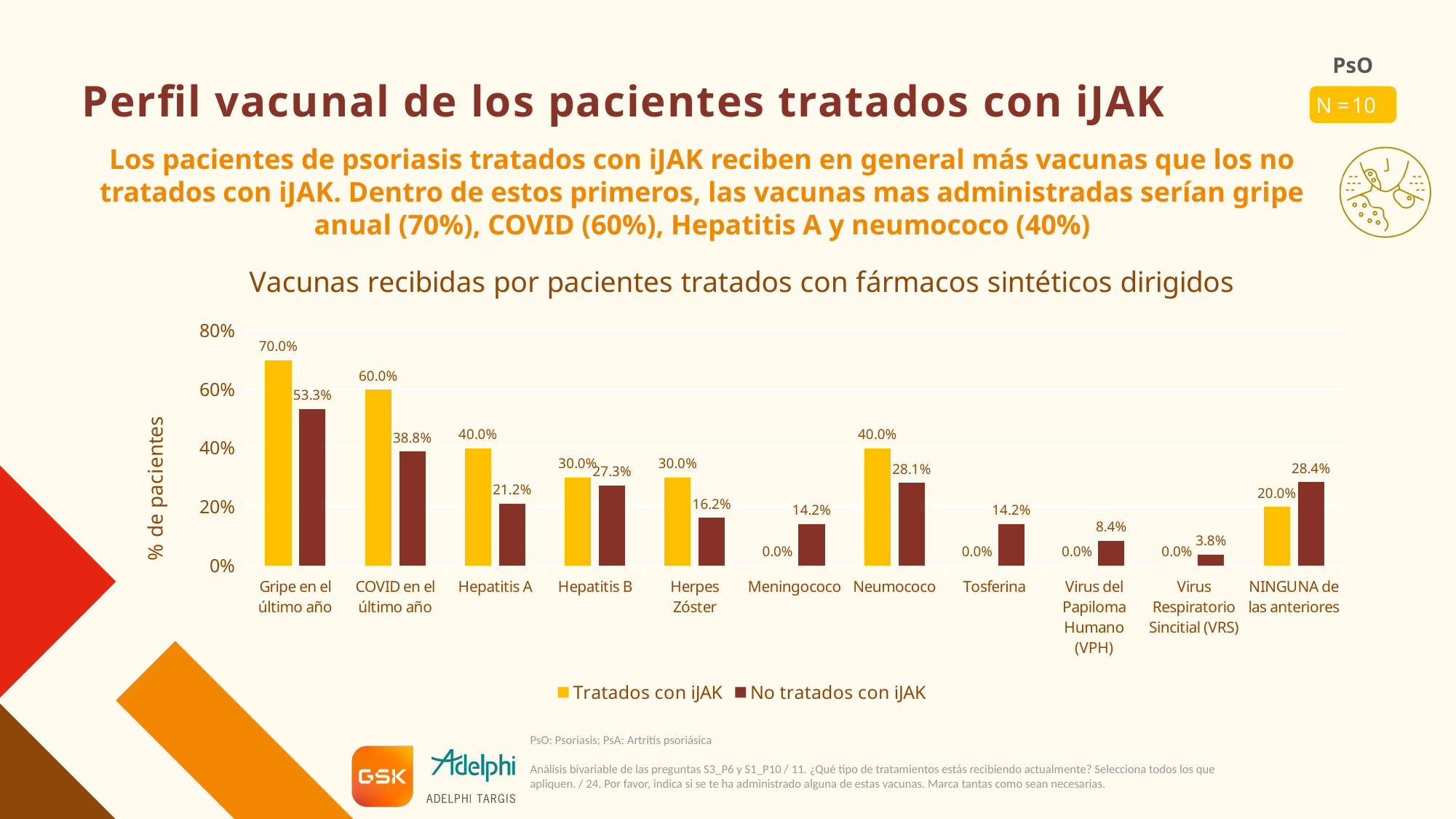
What is the label of the y axis? % de pacientes Which category has the highest value for 'Tratados con iJAK'? Gripe en el último año For NINGUNA de las anteriores, which series has the larger value: 'Tratados con iJAK' or 'No tratados con iJAK'? No tratados con iJAK How many vaccine categories are shown on the x axis? 11 What percentage of patients treated with iJAK received the flu vaccine in the last year (Gripe en el último año)? 70.0% What is the value for 'No tratados con iJAK' for Virus Respiratorio Sincitial (VRS)? 3.8% What is the title of the chart? Vacunas recibidas por pacientes tratados con fármacos sintéticos dirigidos How many series does the legend list? 2 What kind of chart is shown on the slide? Bar chart What is the value for 'No tratados con iJAK' for COVID en el último año? 38.8% What is the difference between 'Tratados con iJAK' and 'No tratados con iJAK' for Hepatitis A? 18.8% Which category has the lowest value for 'No tratados con iJAK'? Virus Respiratorio Sincitial (VRS)